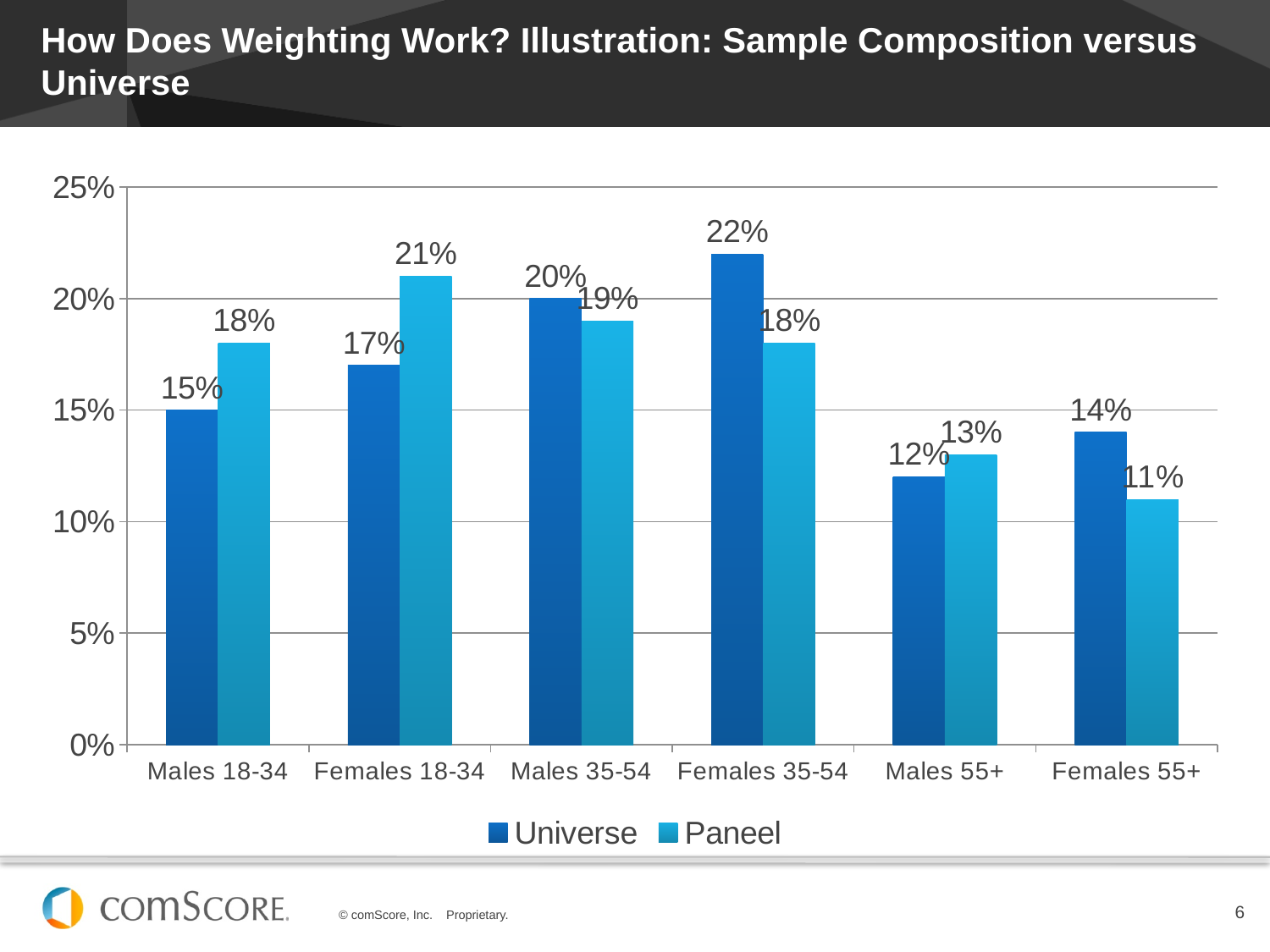
What is the Universe value for Males 18-34? 15% What is the Paneel value for Females 55+? 11% Is the Paneel value for Males 35-54 greater or less than 15%? greater How many categories are shown on the x axis? 6 Which category has the lowest Paneel value? Females 55+ Which is larger for Males 55+, the Universe value or the Paneel value? Paneel How many series does the legend list? 2 What is the difference between the Universe and Paneel values for Females 35-54? 4% Which category has the highest Universe value? Females 35-54 What are the two series named in the legend? Universe and Paneel What is the Paneel value for Females 18-34? 21% What kind of chart is shown on the slide? bar chart